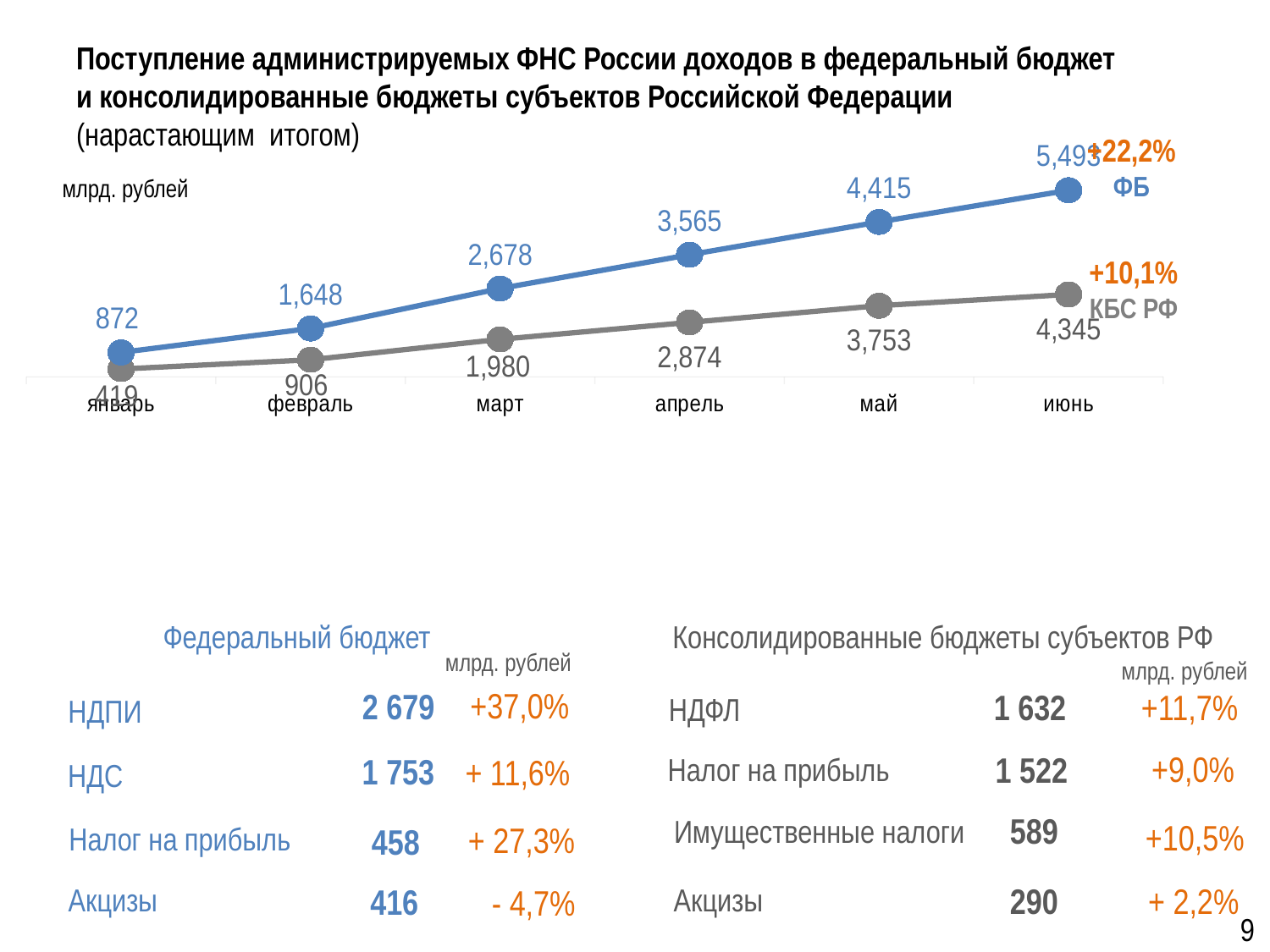
What is the value for КБС РФ in апрель? 2,874 Which is larger in февраль, ФБ or КБС РФ? ФБ What is the value for ФБ in январь? 872 What is the value for КБС РФ in июнь? 4,345 How many series does the line chart show? 2 How many months are plotted on the x axis of the line chart? 6 Do the values of the ФБ series rise or fall from январь to июнь? rise In which month is the КБС РФ series at its highest? июнь What is the value for ФБ in март? 2,678 What kind of chart is shown on the slide? line chart What is the difference between ФБ and КБС РФ in май? 662 In which month is the ФБ series at its lowest? январь